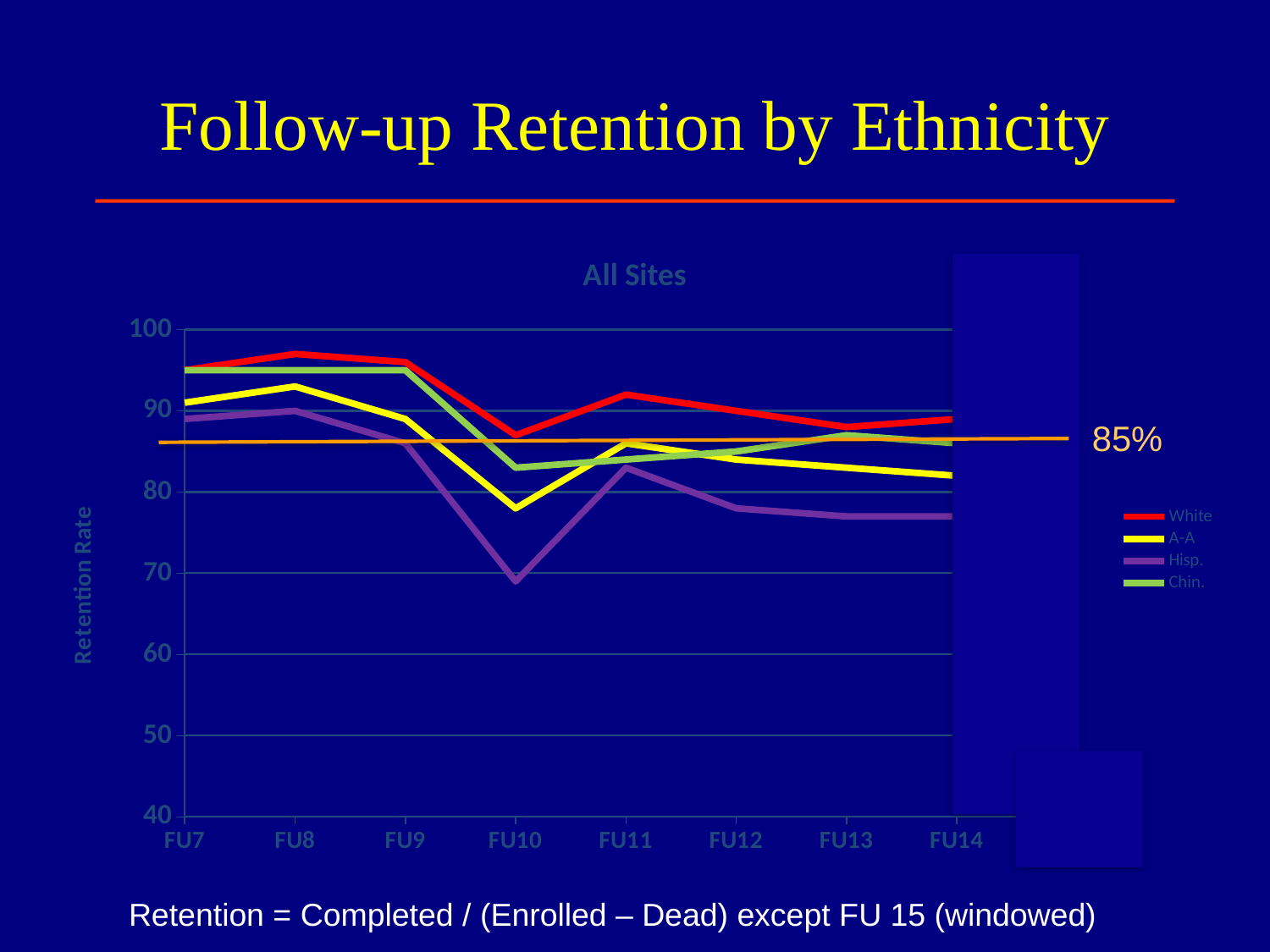
Which series has the lowest retention rate at FU10? Hisp. Is the retention rate for White at FU8 greater or less than 90? greater How many series does the chart's legend list? 4 At FU14, which series has the higher retention rate, White or Hisp.? White Is the retention rate for Hisp. at FU14 greater or less than 80? less Which series has the highest retention rate at FU10? White What kind of chart is shown on the slide? line chart What value does the horizontal orange reference line on the chart mark? 85% What is the title of the chart? All Sites Is the retention rate for Hisp. at FU10 greater or less than 80? less How many follow-up points are shown on the x axis of the chart? 8 Does the retention rate for Hisp. rise or fall from FU7 to FU10? fall